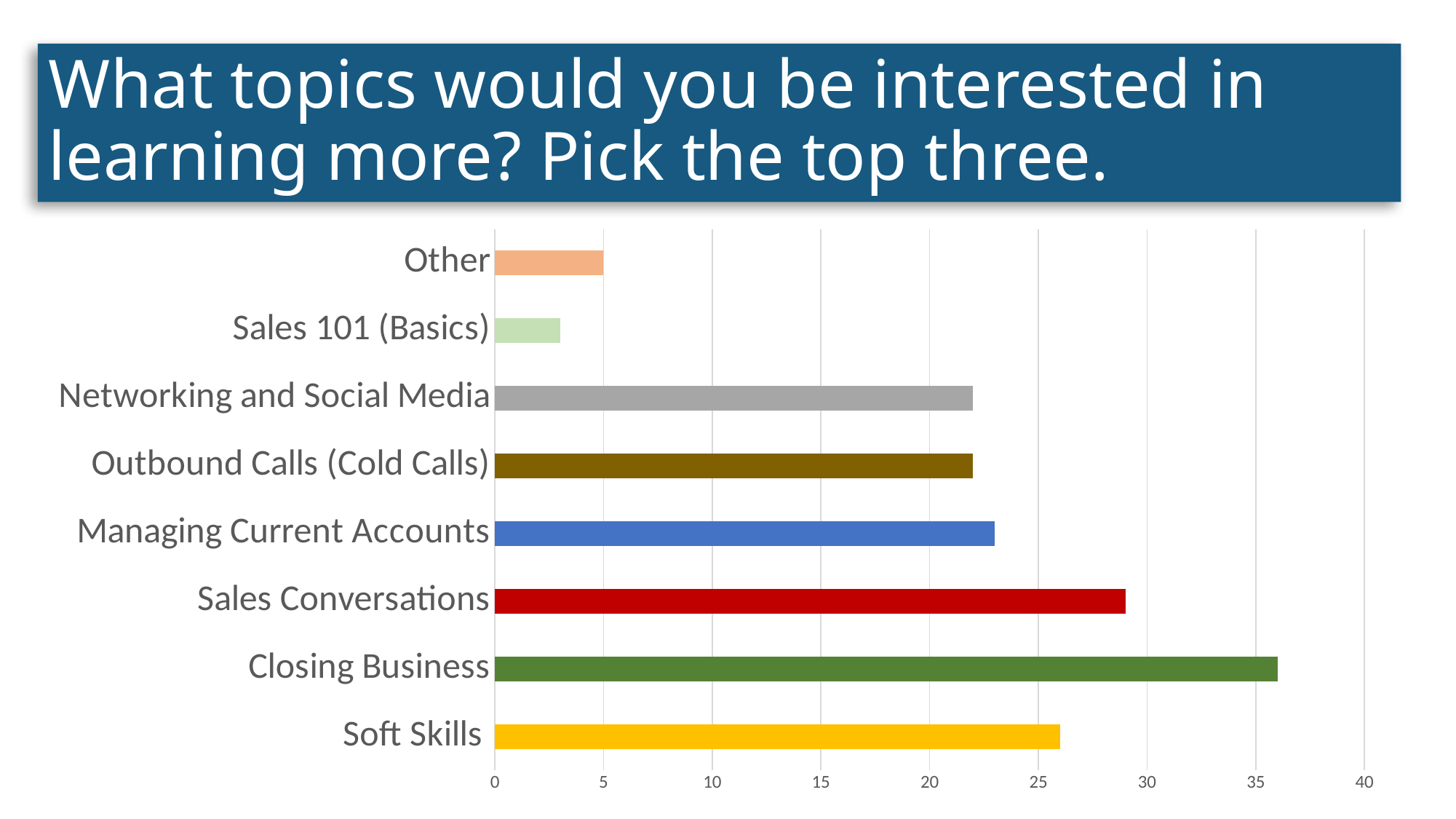
What is the title of the slide containing the chart? What topics would you be interested in learning more? Pick the top three. How many topics (categories) are plotted in the chart? 8 Which has a larger value, Closing Business or Soft Skills? Closing Business Is the value for Sales 101 (Basics) greater or less than 5? less Which topic has the highest value in the chart? Closing Business Is the value for Closing Business greater or less than 35? greater What is the value for Other? 5 Is the value for Sales Conversations greater or less than 30? less Which topic has the lowest value in the chart? Sales 101 (Basics) What kind of chart is shown on the slide? bar chart Which has a larger value, Sales Conversations or Managing Current Accounts? Sales Conversations